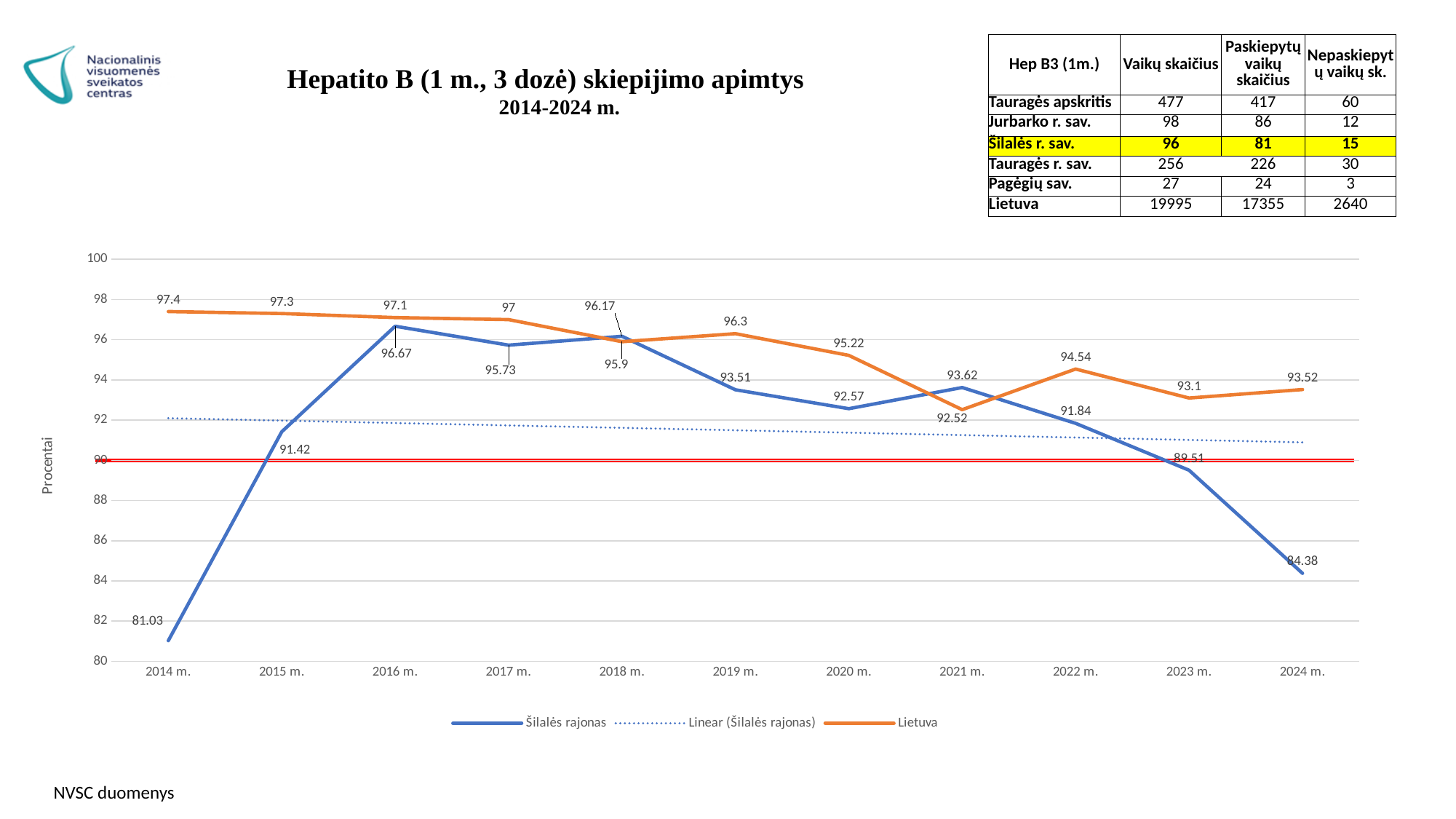
In 2021 m., which series has the larger value, Šilalės rajonas or Lietuva? Šilalės rajonas Does the Lietuva series rise or fall from 2014 m. to 2017 m.? fall How many entries does the legend list? 3 What is the difference between the Lietuva and Šilalės rajonas values in 2024 m.? 9.14 What is the value for Lietuva in 2024 m.? 93.52 What is the value for Lietuva in 2020 m.? 95.22 Is the value for Šilalės rajonas in 2023 m. greater or less than 90? less How many years are shown on the x axis? 11 In which year does the Šilalės rajonas series reach its highest value? 2016 m. In which year does the Lietuva series reach its lowest value? 2021 m. What kind of chart is shown on the slide? line chart What is the value for Šilalės rajonas in 2014 m.? 81.03